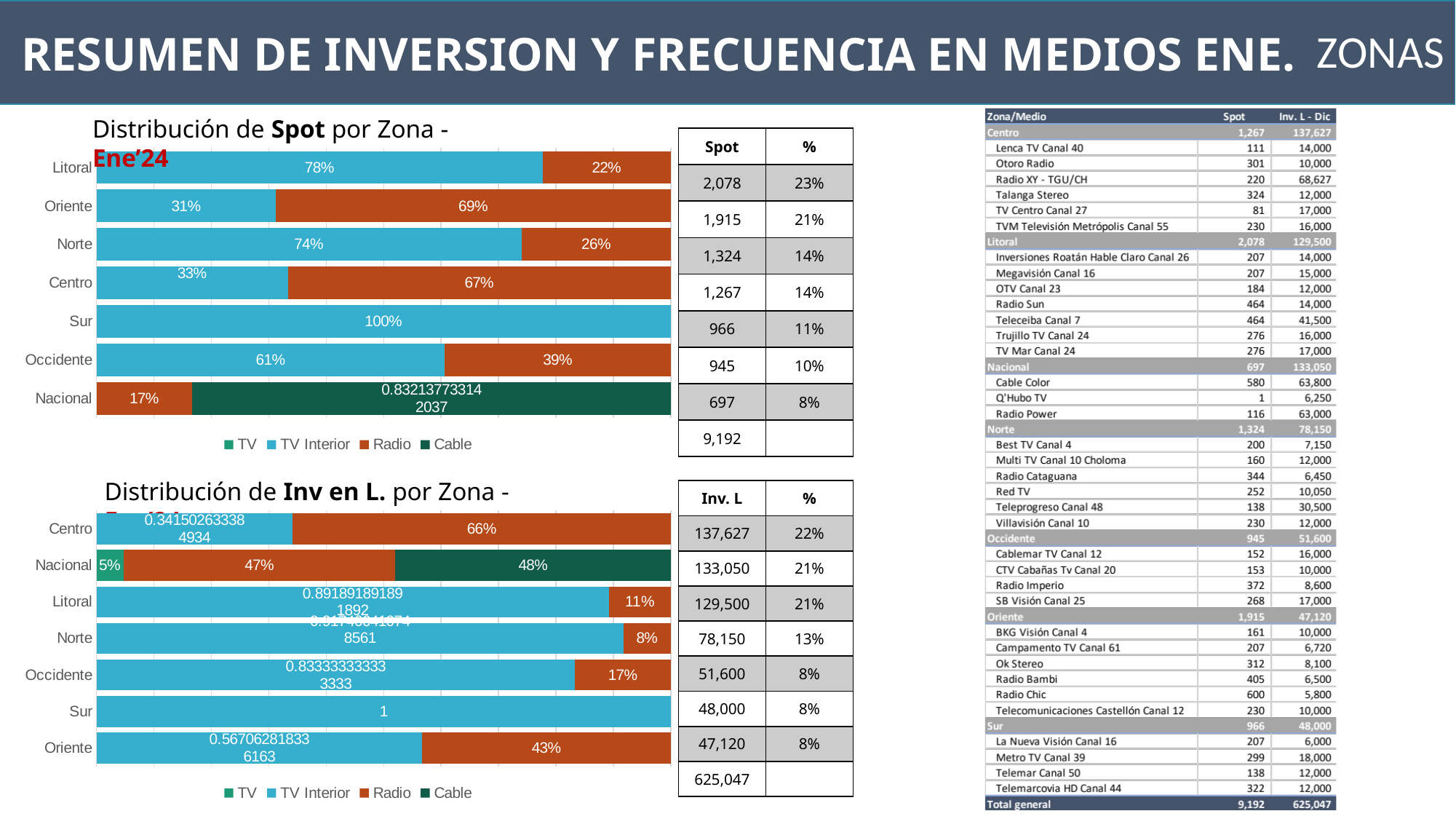
In the 'Distribución de Spot por Zona' chart, what is the difference between the TV Interior and Radio shares for Litoral? 56% In the 'Distribución de Inv en L. por Zona' chart, what is the Cable share for Nacional? 48% What are the legend entries of the 'Distribución de Inv en L. por Zona' chart? TV, TV Interior, Radio, Cable In the 'Distribución de Spot por Zona' chart, what is the Radio share for Nacional? 17% In the 'Distribución de Spot por Zona' chart, what is the Radio share for Oriente? 69% What kind of chart is 'Distribución de Spot por Zona'? bar chart In the 'Distribución de Inv en L. por Zona' chart, what is the Radio share for Oriente? 43% In the 'Distribución de Spot por Zona' chart, what is the TV Interior share for Litoral? 78% In the 'Distribución de Spot por Zona' chart, which zone has the highest Radio share? Oriente How many zones are shown in the 'Distribución de Spot por Zona' chart? 7 How many series does the legend of the 'Distribución de Spot por Zona' chart list? 4 In the 'Distribución de Spot por Zona' chart, which is larger for Norte, TV Interior or Radio? TV Interior